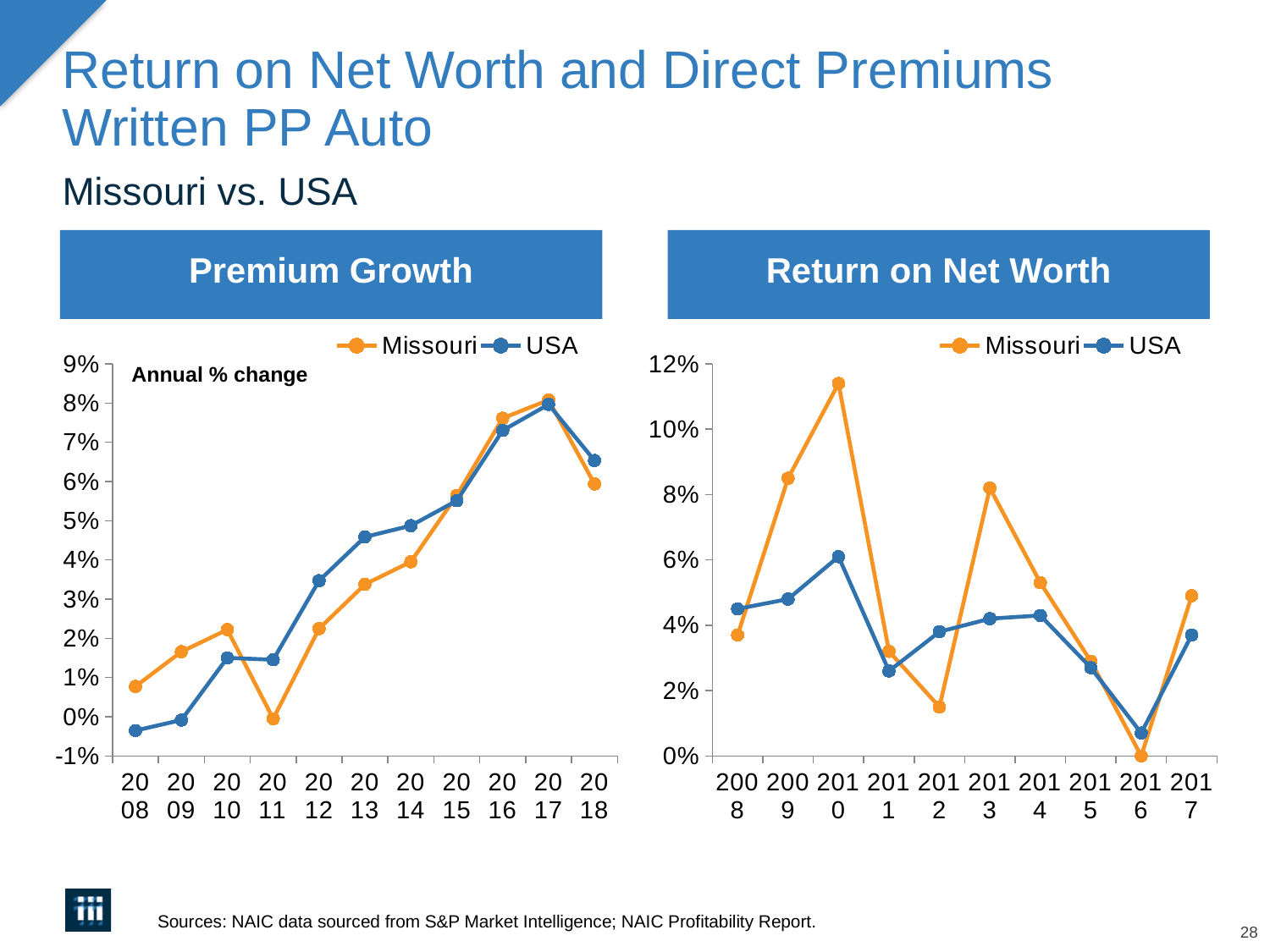
In the Premium Growth chart, in which year is the Missouri value highest? 2017 How many years are plotted on the x axis of the Premium Growth chart? 11 In the Return on Net Worth chart, in which year is the Missouri value lowest? 2016 In the Return on Net Worth chart, is the Missouri value for 2010 greater or less than 10%? greater How many years are plotted on the x axis of the Return on Net Worth chart? 10 In the Premium Growth chart, is the USA value for 2008 greater or less than 0%? less What kind of chart is the Premium Growth chart? line chart How many series does the legend of the Return on Net Worth chart list? 2 In the Premium Growth chart, in which year is the USA value lowest? 2008 In the Return on Net Worth chart, in which year is the Missouri value highest? 2010 In the Return on Net Worth chart, which series has the larger value in 2009, Missouri or USA? Missouri In the Premium Growth chart, which series has the larger value in 2013, Missouri or USA? USA